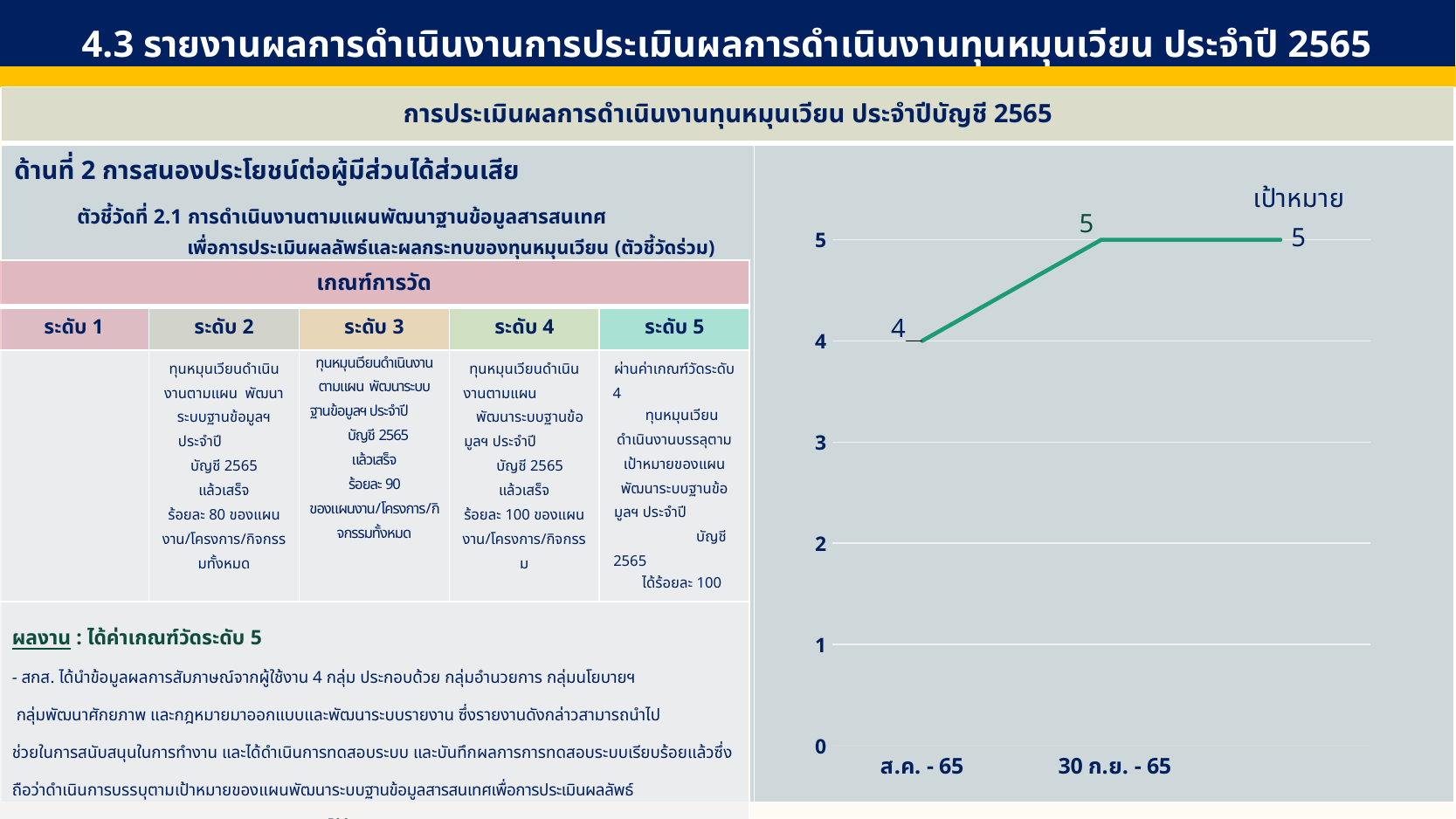
What is the value shown for เป้าหมาย? 5 What is the value plotted for 30 ก.ย. - 65? 5 Does the value for 30 ก.ย. - 65 equal the เป้าหมาย value? yes Is the value for ส.ค. - 65 greater or less than 3? greater What is the value plotted for ส.ค. - 65? 4 How many data points are plotted on the line chart? 3 Which is larger, the value for ส.ค. - 65 or the value for 30 ก.ย. - 65? 30 ก.ย. - 65 Does the line rise or fall from ส.ค. - 65 to 30 ก.ย. - 65? rise Which point has the lowest value on the line chart? ส.ค. - 65 What is the difference between the value for 30 ก.ย. - 65 and the value for ส.ค. - 65? 1 What is the maximum value shown on the y axis of the line chart? 5 What type of chart is shown on the right side of the slide? line chart